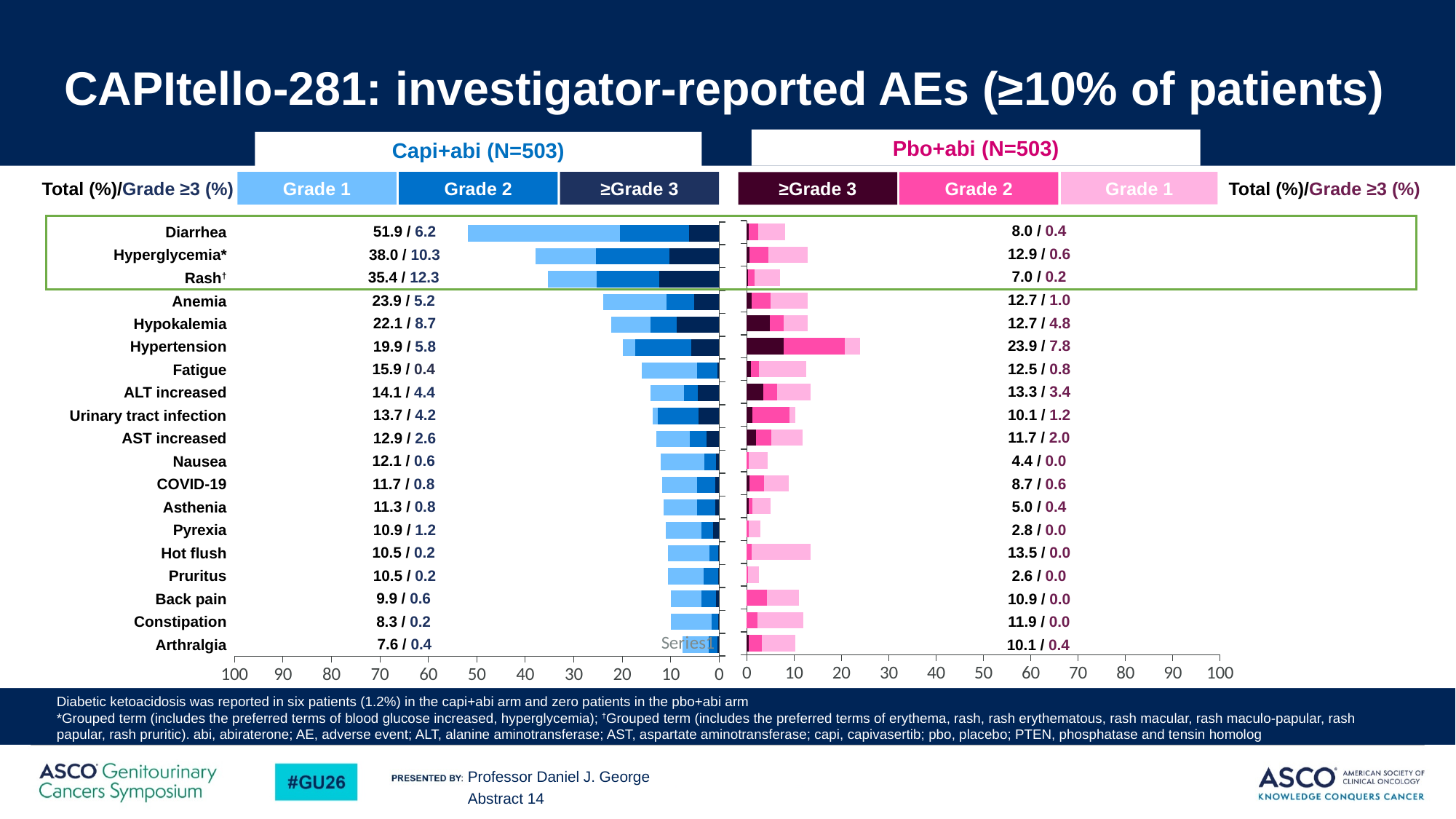
How many grade categories does the legend list for each treatment arm? 3 How many adverse events are listed in the chart? 19 Which adverse event has the highest total percentage in the Pbo+abi arm? Hypertension For hot flush, which arm has the higher total percentage, Capi+abi or Pbo+abi? Pbo+abi Which adverse event has the lowest total percentage in the Capi+abi arm? Arthralgia What is the difference in total percentage for diarrhea between the Capi+abi arm and the Pbo+abi arm? 43.9 What is the difference in Grade ≥3 percentage for hypokalemia between the Capi+abi arm and the Pbo+abi arm? 3.9 What kind of chart is shown on the slide? Bar chart What is the Grade ≥3 percentage for hyperglycemia in the Capi+abi arm? 10.3 Which adverse event has the highest total percentage in the Capi+abi arm? Diarrhea What is the total percentage of patients with hypertension in the Pbo+abi arm? 23.9 What is the total percentage of patients with diarrhea in the Capi+abi arm? 51.9